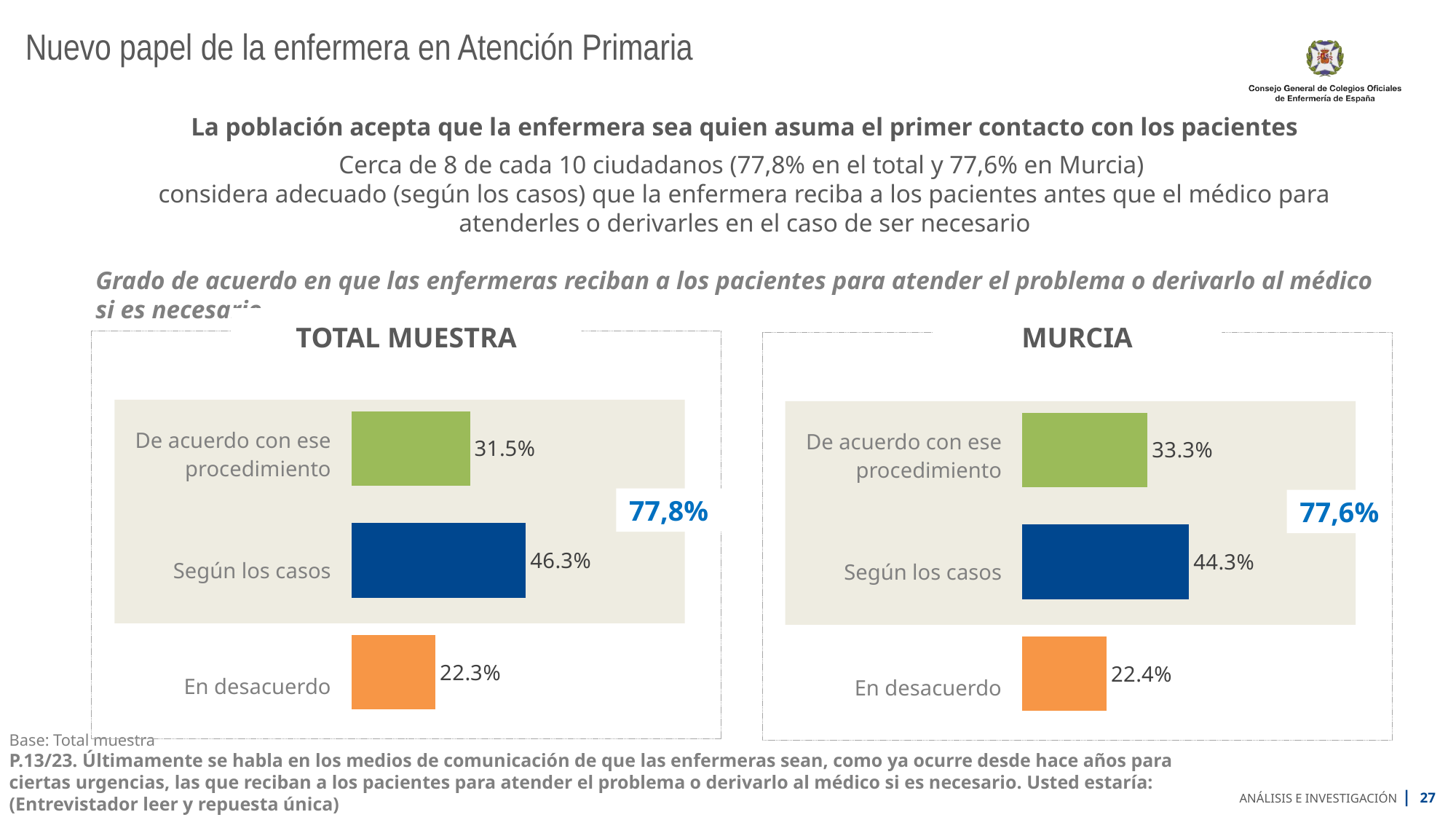
In the MURCIA chart, what is the difference between "Según los casos" and "En desacuerdo"? 21.9% In the TOTAL MUESTRA chart, which category has the highest value? Según los casos In the TOTAL MUESTRA chart, what is the difference between "Según los casos" and "De acuerdo con ese procedimiento"? 14.8% What combined percentage is highlighted in blue on the MURCIA chart? 77,6% In the MURCIA chart, what is the value for "En desacuerdo"? 22.4% Which is larger in the TOTAL MUESTRA chart: "De acuerdo con ese procedimiento" or "En desacuerdo"? De acuerdo con ese procedimiento What kind of chart is the TOTAL MUESTRA chart? Bar chart In the MURCIA chart, what is the value for "De acuerdo con ese procedimiento"? 33.3% In the MURCIA chart, which category has the lowest value? En desacuerdo How many categories does the MURCIA chart show? 3 In the TOTAL MUESTRA chart, what colour is the bar for "En desacuerdo"? Orange In the TOTAL MUESTRA chart, what is the value for "Según los casos"? 46.3%